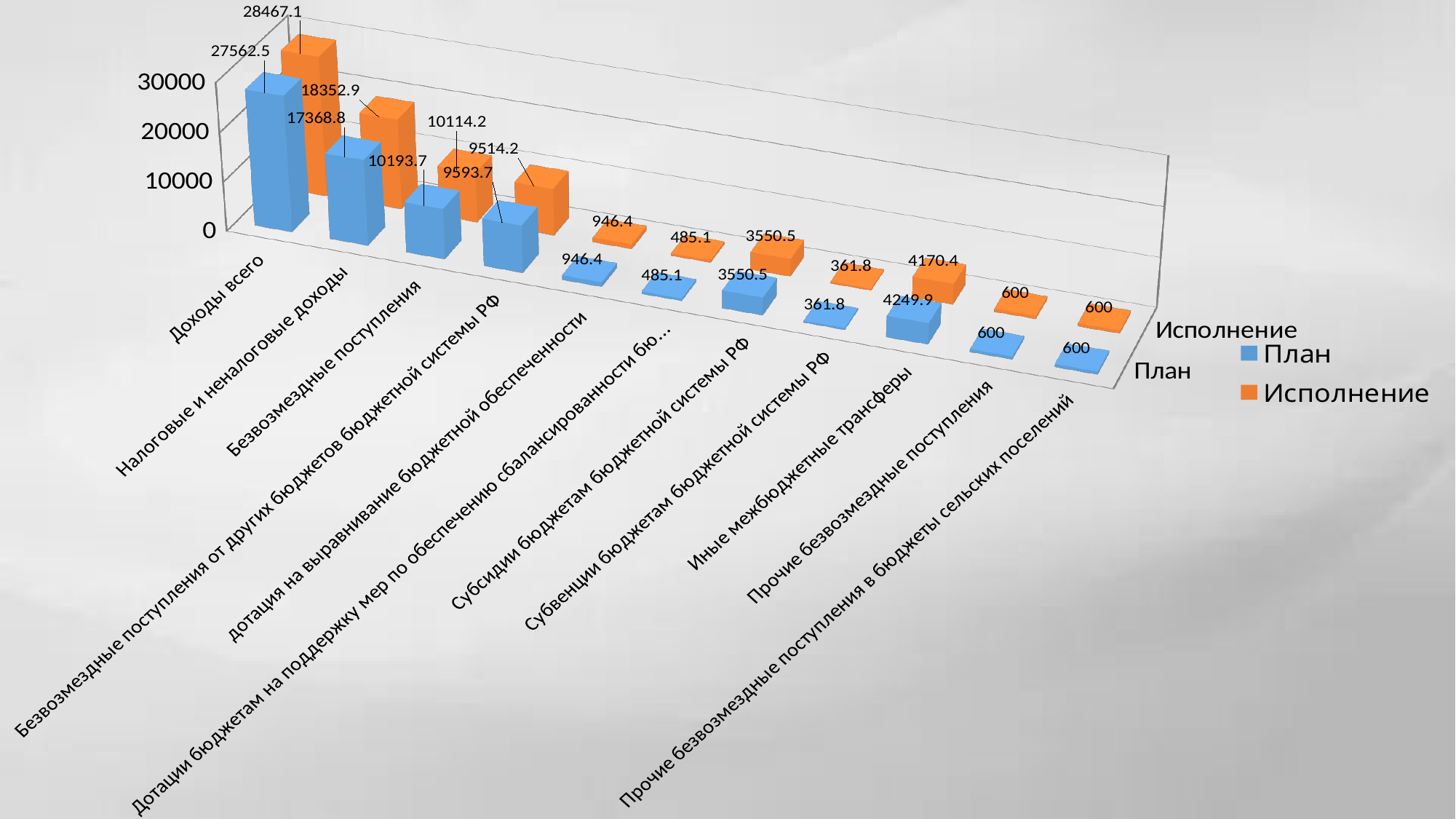
What is the difference between the Исполнение and План values for Доходы всего? 904.6 Which category has the lowest План value? Субвенции бюджетам бюджетной системы РФ What kind of chart is shown on the slide? bar chart What is the План value for Доходы всего? 27562.5 What is the Исполнение value for Налоговые и неналоговые доходы? 18352.9 How many series does the legend list? 2 What is the Исполнение value for Субвенции бюджетам бюджетной системы РФ? 361.8 How many categories are plotted along the x axis? 11 Which colour represents the Исполнение series in the legend? orange For Субсидии бюджетам бюджетной системы РФ, is the План value greater or less than 10000? less Which category has the highest Исполнение value? Доходы всего What is the План value for Иные межбюджетные трансферы? 4249.9